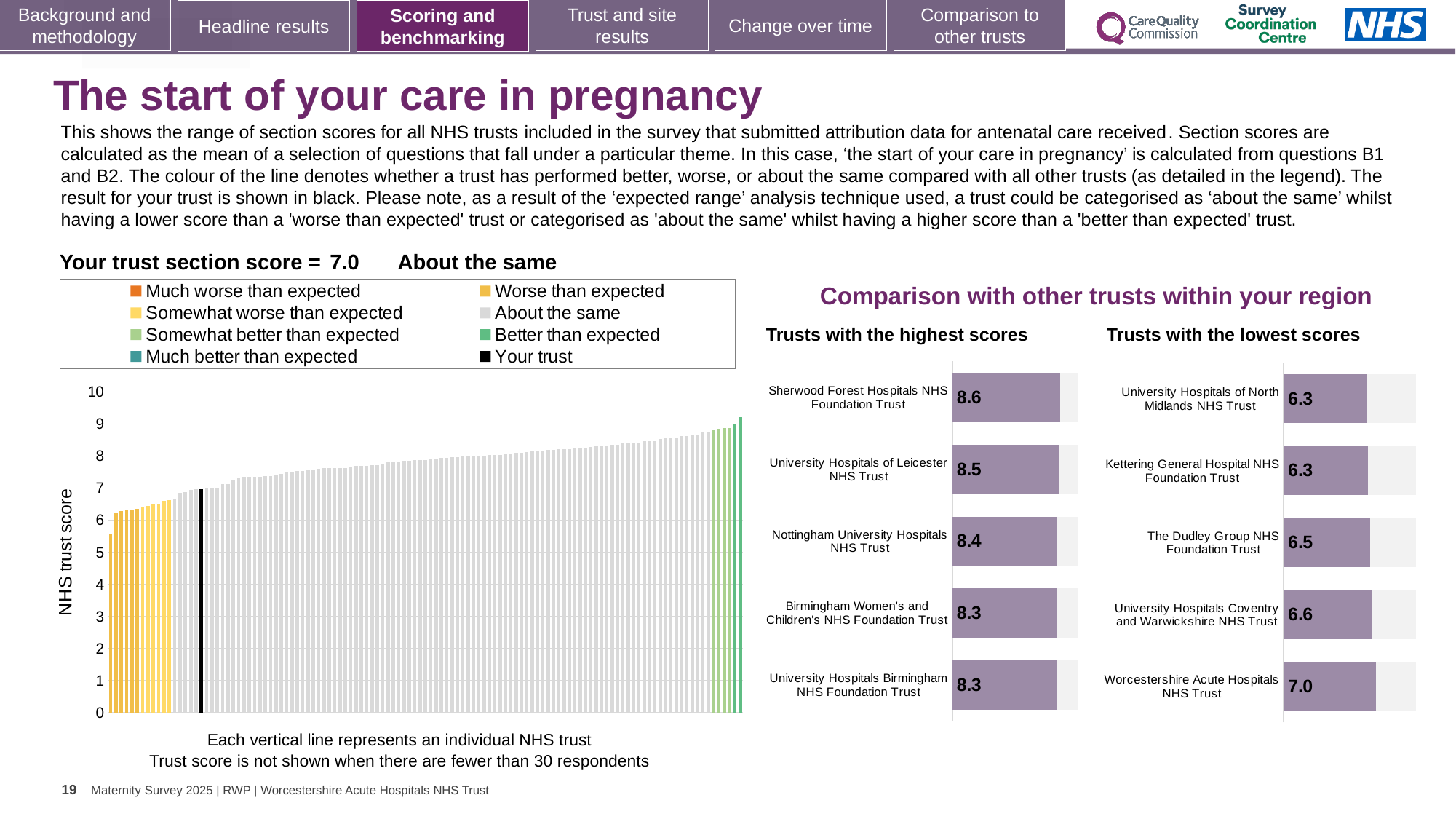
On the large chart on the left, is the value of the leftmost bar greater or less than 6? less On the large chart on the left, do the bar values rise or fall from left to right? Rise How many trusts are shown on the 'Trusts with the highest scores' chart? 5 On the 'Trusts with the highest scores' chart, which trust has the highest score? Sherwood Forest Hospitals NHS Foundation Trust On the 'Trusts with the highest scores' chart, what is the difference between the scores of Sherwood Forest Hospitals NHS Foundation Trust and University Hospitals Birmingham NHS Foundation Trust? 0.3 On the 'Trusts with the highest scores' chart, what is the score for Sherwood Forest Hospitals NHS Foundation Trust? 8.6 How many entries does the legend above the large chart on the left list? 8 On the 'Trusts with the lowest scores' chart, what is the difference between the scores of Worcestershire Acute Hospitals NHS Trust and Kettering General Hospital NHS Foundation Trust? 0.7 On the 'Trusts with the lowest scores' chart, which has the larger score: The Dudley Group NHS Foundation Trust or University Hospitals Coventry and Warwickshire NHS Trust? University Hospitals Coventry and Warwickshire NHS Trust What kind of chart is the large chart on the left showing NHS trust scores? Bar chart On the 'Trusts with the lowest scores' chart, what is the score for The Dudley Group NHS Foundation Trust? 6.5 On the 'Trusts with the lowest scores' chart, which trust has the highest score? Worcestershire Acute Hospitals NHS Trust